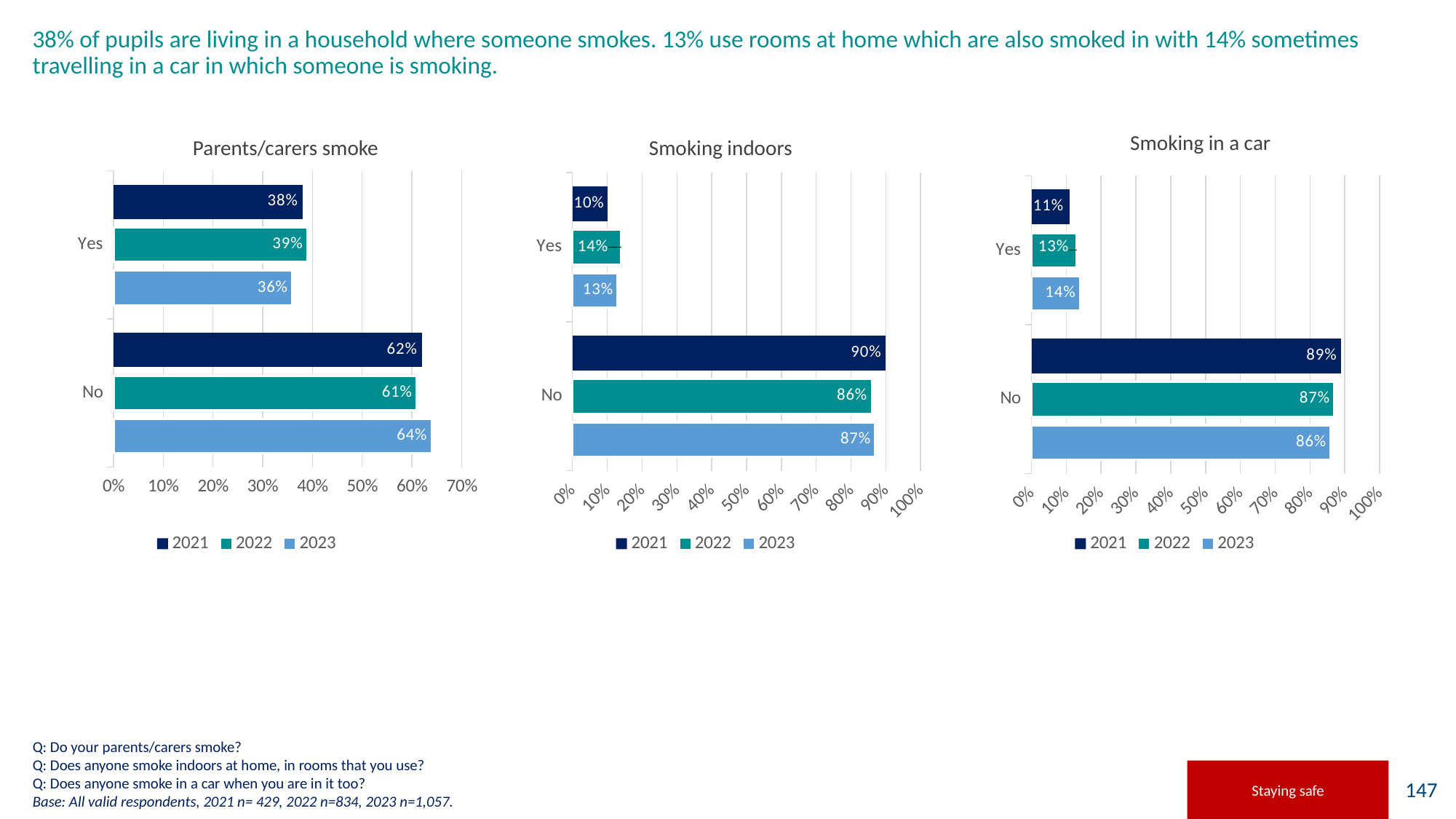
What kind of chart is the 'Parents/carers smoke' chart? Bar chart In the 'Smoking indoors' chart, what is the value for 'Yes' in 2022? 14% In the 'Smoking in a car' chart, which year has the lowest value for 'Yes'? 2021 In the 'Parents/carers smoke' chart, what is the value for 'No' in 2023? 64% In the 'Parents/carers smoke' chart, what is the difference between the 'No' value in 2023 and the 'No' value in 2022? 3% What is the title of the middle chart on the slide? Smoking indoors In the 'Parents/carers smoke' chart, what is the value for 'Yes' in 2021? 38% In the 'Smoking indoors' chart, which is larger: the 'Yes' value for 2022 or the 'Yes' value for 2023? 2022 How many series does the legend list in the 'Smoking in a car' chart? 3 In the 'Smoking indoors' chart, which year has the highest value for 'No'? 2021 In the 'Smoking in a car' chart, what is the difference between the 'No' value in 2021 and the 'Yes' value in 2021? 78% In the 'Smoking in a car' chart, what is the value for 'No' in 2021? 89%